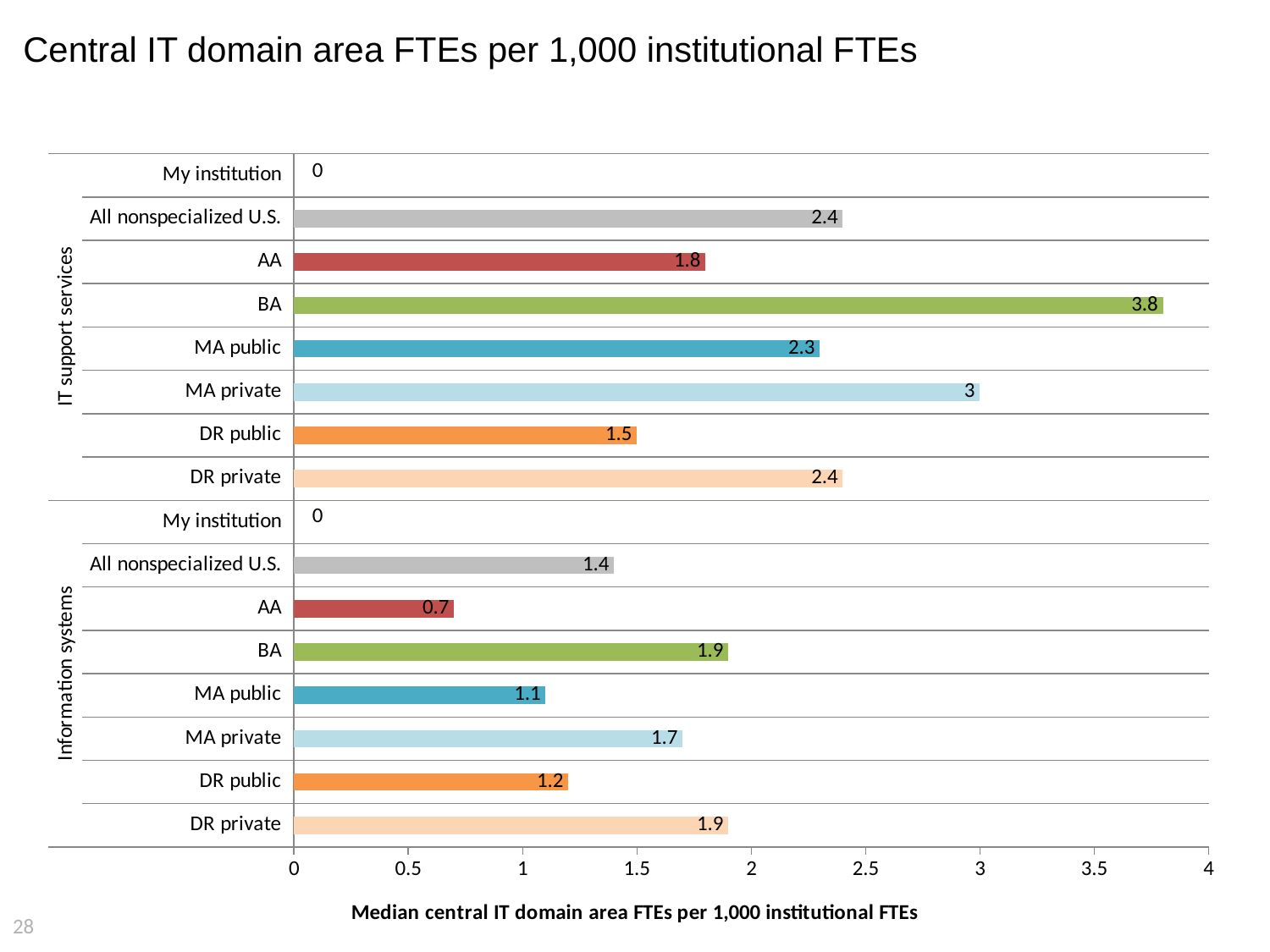
What is the difference between the BA values for IT support services and Information systems? 1.9 What kind of chart is shown on the slide? Bar chart What is the value for MA private under IT support services? 3 What is the value for BA under IT support services? 3.8 Which is larger under Information systems: MA private or MA public? MA private Which category has the lowest non-zero value under Information systems? AA What is the value for All nonspecialized U.S. under Information systems? 1.4 How many bars are plotted under the Information systems group? 8 What is the x-axis title of the chart? Median central IT domain area FTEs per 1,000 institutional FTEs Is the value for DR private under IT support services greater or less than 2? greater Which category has the highest value under IT support services? BA What is the value for DR public under Information systems? 1.2